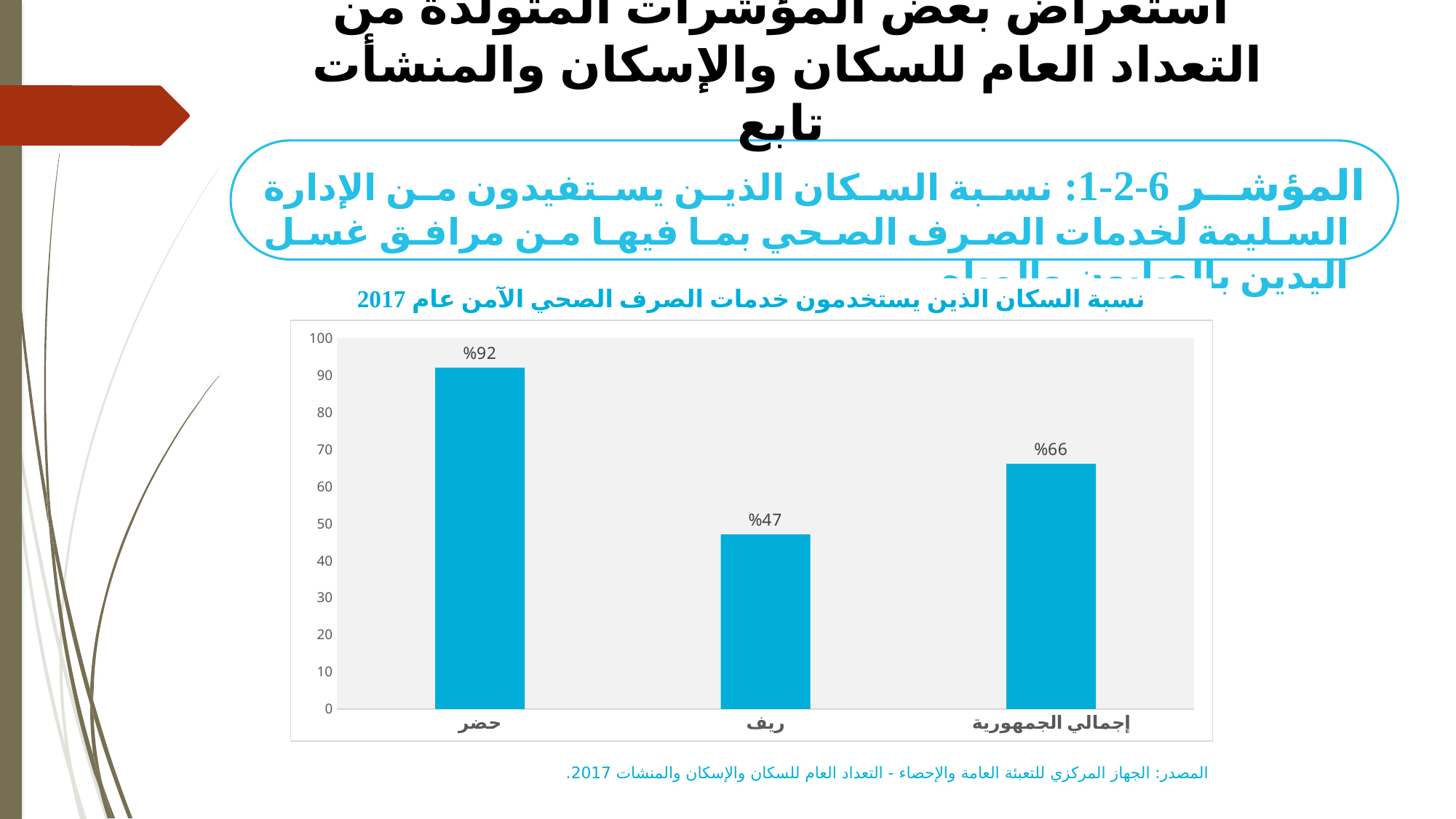
Is the value for ريف greater or less than 50? less What is the difference between the values for حضر and إجمالي الجمهورية? 26 percentage points Which category has the highest value in the chart? حضر Which is larger, the value for ريف or the value for إجمالي الجمهورية? إجمالي الجمهورية What kind of chart is shown on the slide? bar chart How many categories are shown in the chart? 3 What is the value for ريف in the chart? 47% What is the value for حضر in the chart? 92% Which category has the lowest value in the chart? ريف What year does the chart title refer to? 2017 What is the difference between the values for حضر and ريف? 45 percentage points What is the value for إجمالي الجمهورية in the chart? 66%